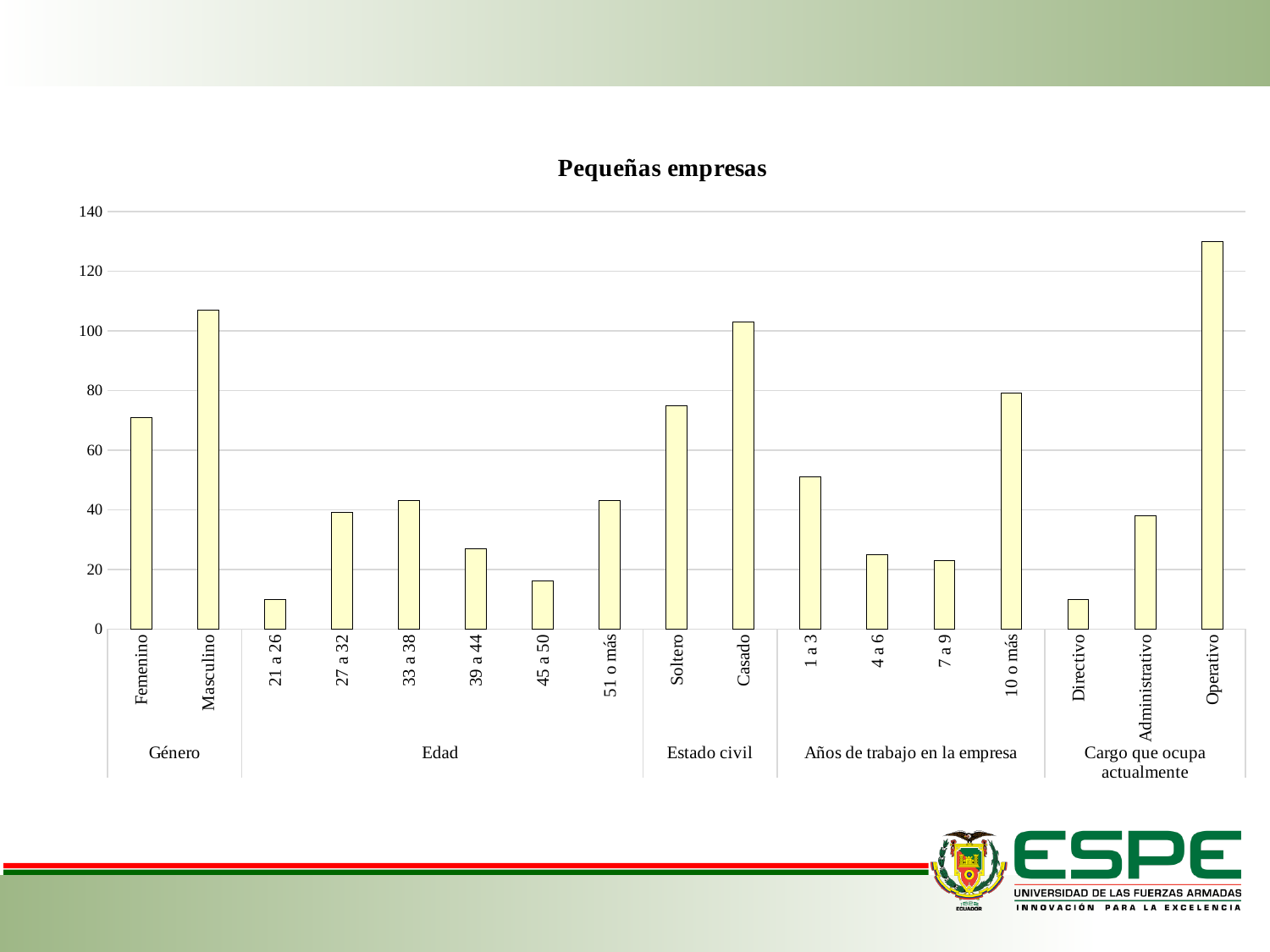
What type of chart is shown on the slide? bar chart How many category groups are shown along the x axis (Género, Edad, etc.)? 5 Is the value for Operativo greater or less than 120? greater Which category has the highest bar in the chart? Operativo Is the value for Masculino greater or less than 100? greater Which is larger, the value for Casado or the value for Soltero? Casado Within the Edad group, which category has the lowest bar? 21 a 26 How many bars are plotted in the chart? 17 What is the title of the chart? Pequeñas empresas Within the Cargo que ocupa actualmente group, which category has the lowest bar? Directivo Is the value for 45 a 50 greater or less than 20? less Which is larger, the value for 1 a 3 or the value for 10 o más? 10 o más